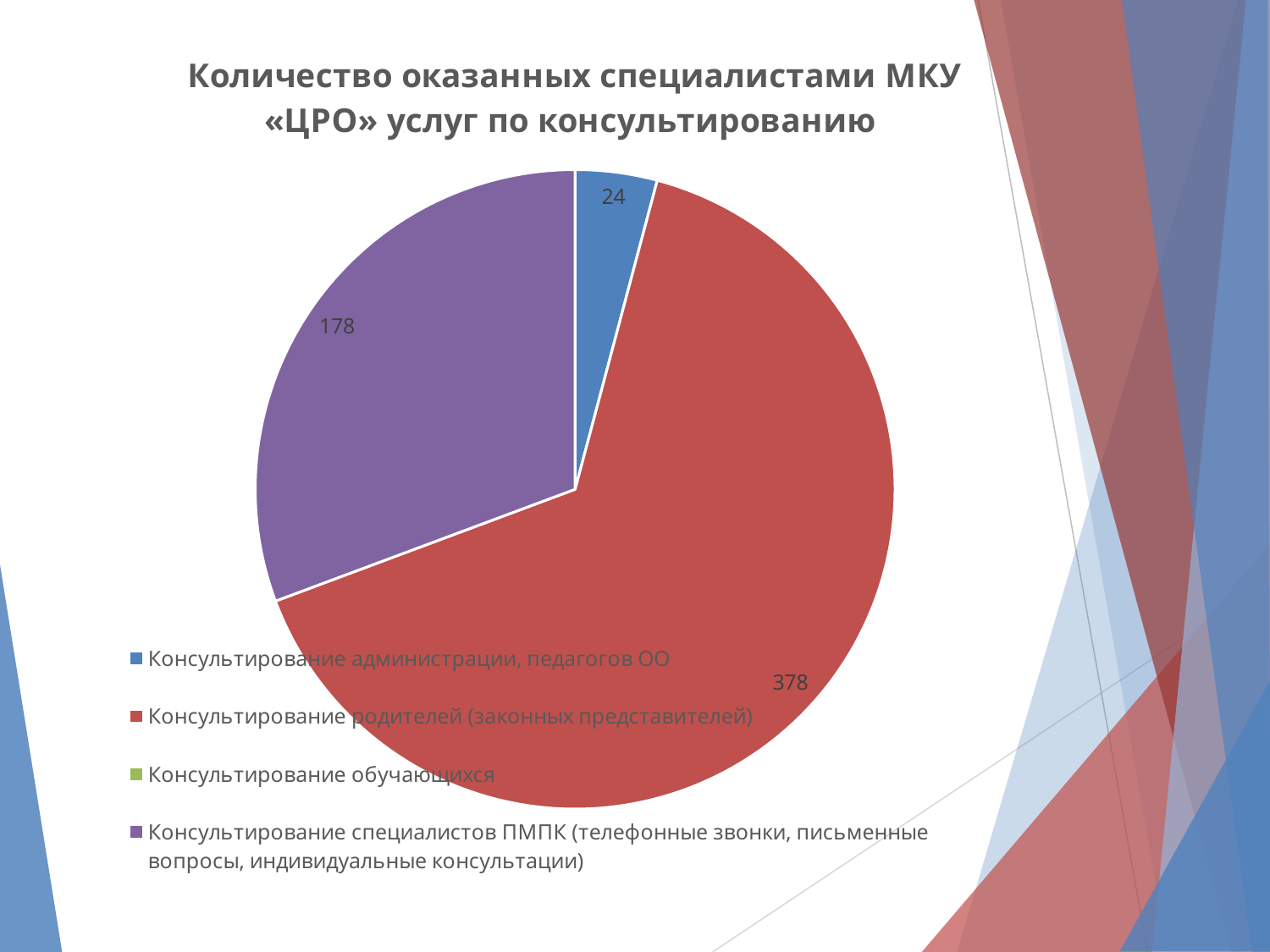
Which is larger: the value for «Консультирование специалистов ПМПК» or the value for «Консультирование администрации, педагогов ОО»? Консультирование специалистов ПМПК What is the value for «Консультирование родителей (законных представителей)»? 378 What colour is the slice for «Консультирование родителей (законных представителей)»? Red What is the difference between the value for «Консультирование специалистов ПМПК» and the value for «Консультирование администрации, педагогов ОО»? 154 Which category has the largest slice of the pie? Консультирование родителей (законных представителей) How many categories does the legend list? 4 How many slices are visible in the pie? 3 What type of chart is shown on the slide? Pie chart What is the value for «Консультирование специалистов ПМПК (телефонные звонки, письменные вопросы, индивидуальные консультации)»? 178 What is the title of the chart? Количество оказанных специалистами МКУ «ЦРО» услуг по консультированию What is the value for «Консультирование администрации, педагогов ОО»? 24 What is the difference between the value for «Консультирование родителей (законных представителей)» and the value for «Консультирование специалистов ПМПК»? 200